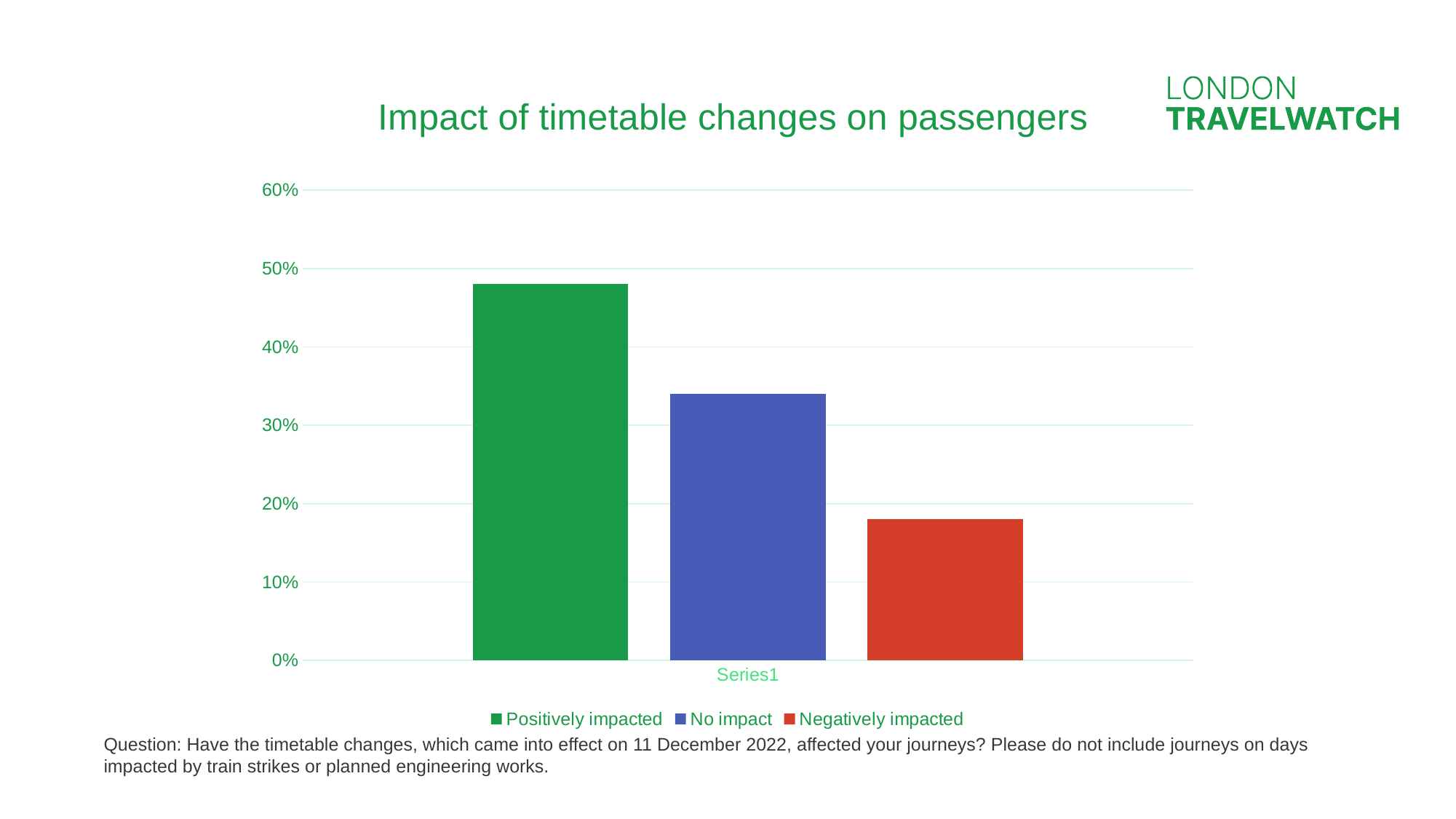
Is the value for Positively impacted greater or less than 40%? greater What is the title of the chart? Impact of timetable changes on passengers Which group has the tallest bar in the chart? Positively impacted How many entries does the legend list? 3 What type of chart is shown on the slide? bar chart How many bars are plotted in the chart? 3 Is the value for No impact greater or less than 40%? less Which group has the shortest bar in the chart? Negatively impacted Is the value for No impact greater or less than 30%? greater Which is larger, the value for No impact or the value for Negatively impacted? No impact